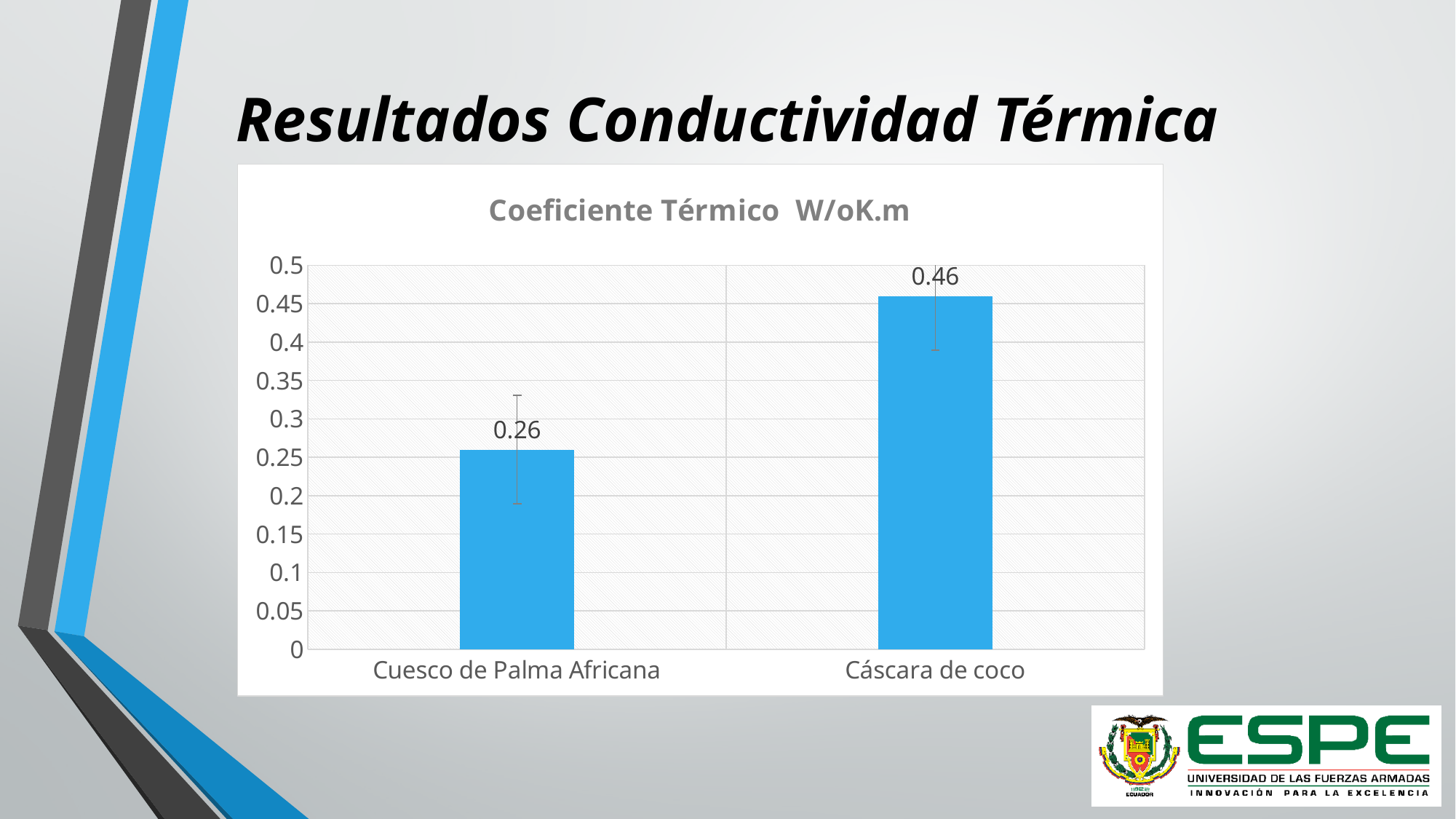
Which category has the highest value? Cáscara de coco What kind of chart is shown on the slide? Bar chart What is the difference between the values for Cáscara de coco and Cuesco de Palma Africana? 0.2 Is the value for Cáscara de coco greater or less than 0.4? greater How many categories are shown on the chart? 2 What is the maximum value shown on the vertical axis? 0.5 Which category has the lowest value? Cuesco de Palma Africana What is the title of the chart? Coeficiente Térmico W/oK.m What is the value for Cuesco de Palma Africana? 0.26 Is the value for Cuesco de Palma Africana greater or less than 0.3? less What is the value for Cáscara de coco? 0.46 Which is larger, the value for Cuesco de Palma Africana or the value for Cáscara de coco? Cáscara de coco